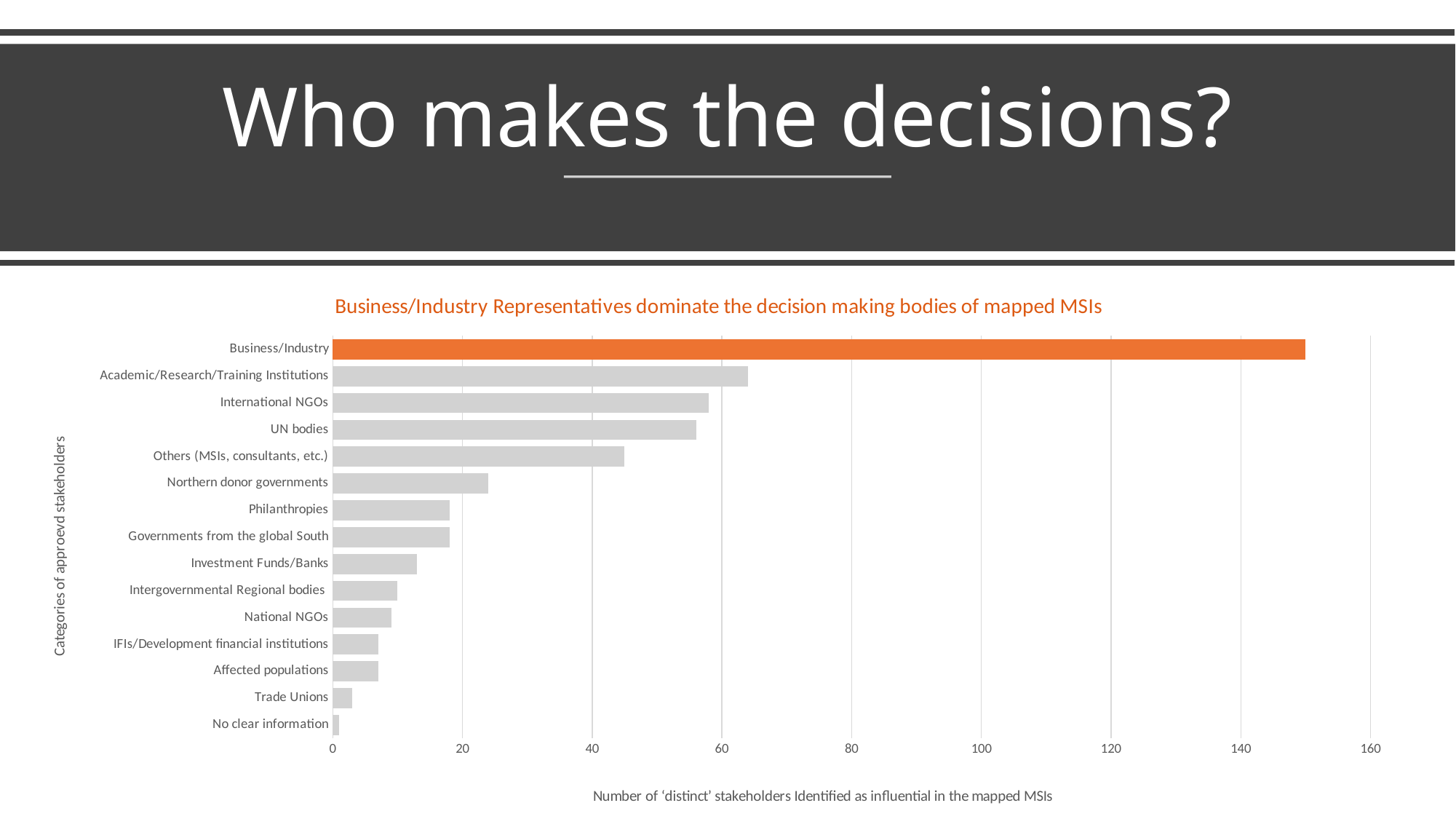
Which category has the highest number of distinct stakeholders? Business/Industry Is the value for Others (MSIs, consultants, etc.) greater or less than 40? greater Which has a larger value: Northern donor governments or Philanthropies? Northern donor governments Is the value for Business/Industry greater or less than 140? greater What kind of chart is shown on the slide? Bar chart Is the value for Academic/Research/Training Institutions greater or less than 60? greater What is the title of the chart? Business/Industry Representatives dominate the decision making bodies of mapped MSIs Which category has the lowest number of distinct stakeholders? No clear information Which has a larger value: UN bodies or Others (MSIs, consultants, etc.)? UN bodies How many categories of stakeholders are plotted in the chart? 15